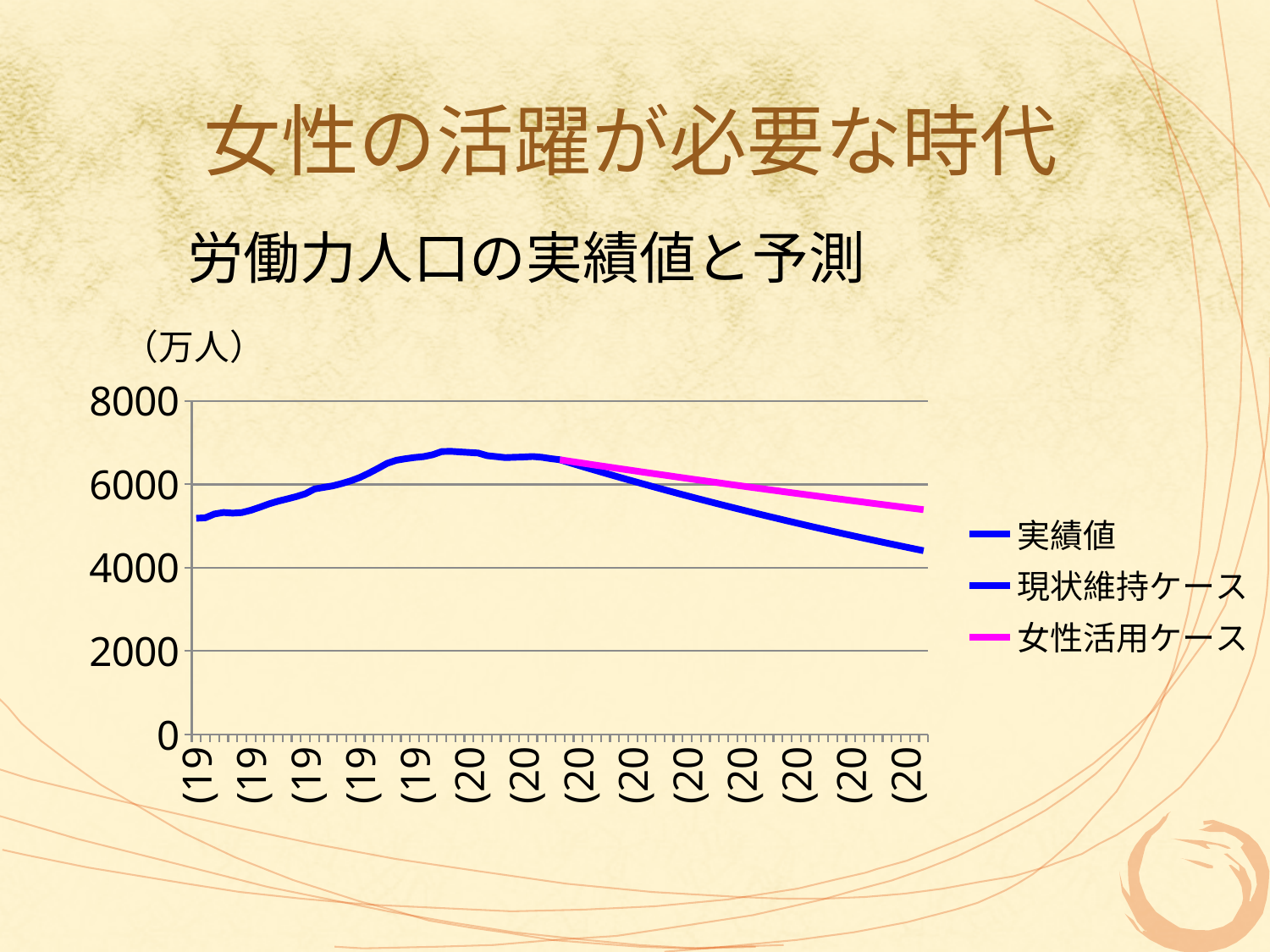
What is the title of the chart? 労働力人口の実績値と予測 Does the 現状維持ケース line rise or fall from left to right? fall Is the value at the right end of the 女性活用ケース line greater or less than 6000? less What unit is shown above the vertical axis of the chart? 万人 Is the highest point of the 実績値 line greater or less than 6000? greater Is the value at the right end of the 現状維持ケース line greater or less than 6000? less How many series does the legend list? 3 At the right end of the chart, which series is higher: 現状維持ケース or 女性活用ケース? 女性活用ケース What kind of chart is shown on the slide? line chart Which series is drawn in magenta? 女性活用ケース